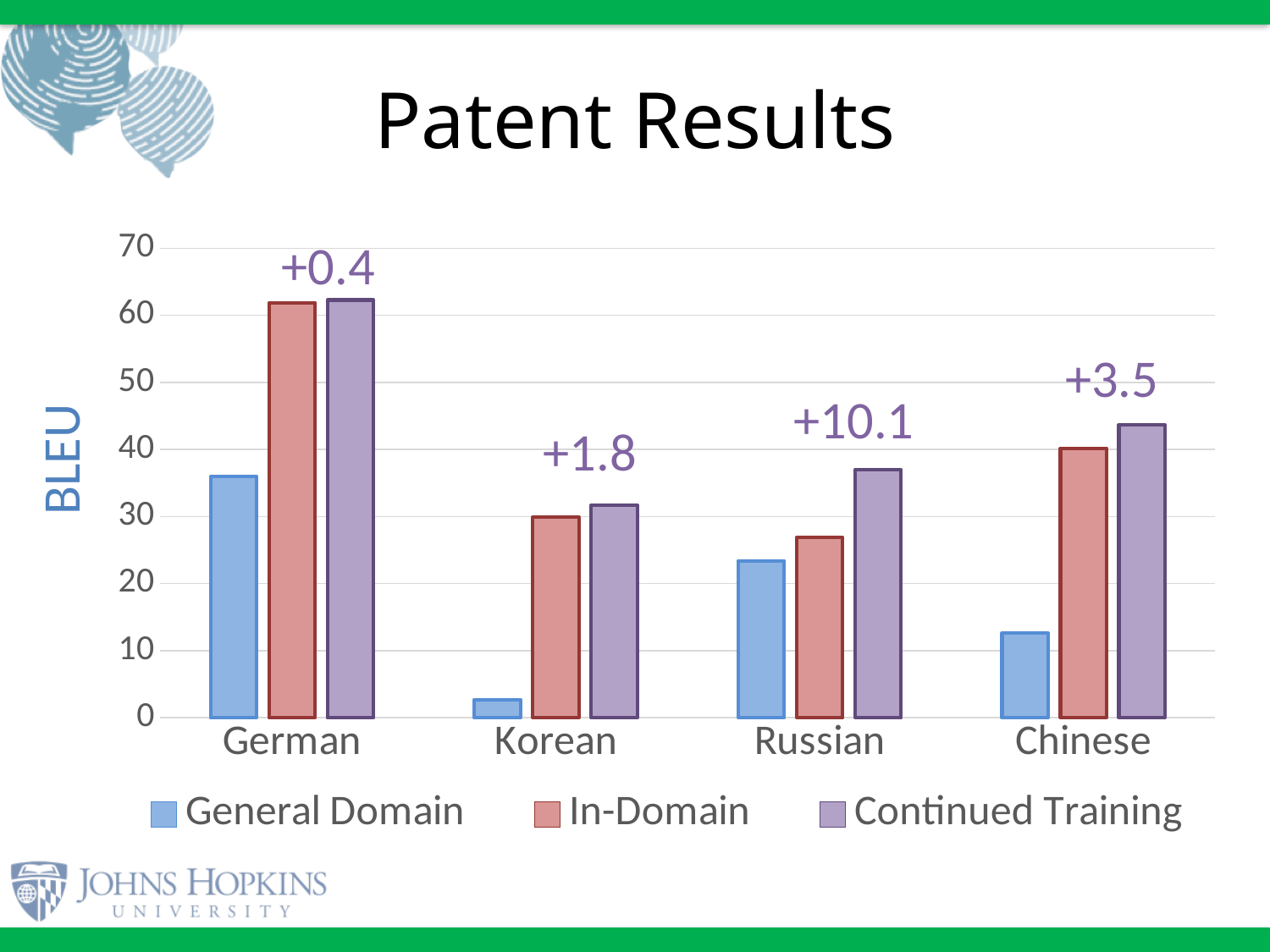
How many series does the legend list? 3 Which language has the highest Continued Training BLEU score? German Which is larger, the General Domain BLEU score for Russian or for Chinese? Russian Which language has the largest annotated improvement? Russian What improvement is annotated above the German bars? +0.4 What is the label on the y axis of the chart? BLEU What improvement is annotated above the Russian bars? +10.1 Which language has the lowest General Domain BLEU score? Korean What improvement is annotated above the Chinese bars? +3.5 What type of chart is shown on the slide? bar chart Is the General Domain BLEU score for German greater or less than 30? greater How many languages are shown on the x axis of the chart? 4